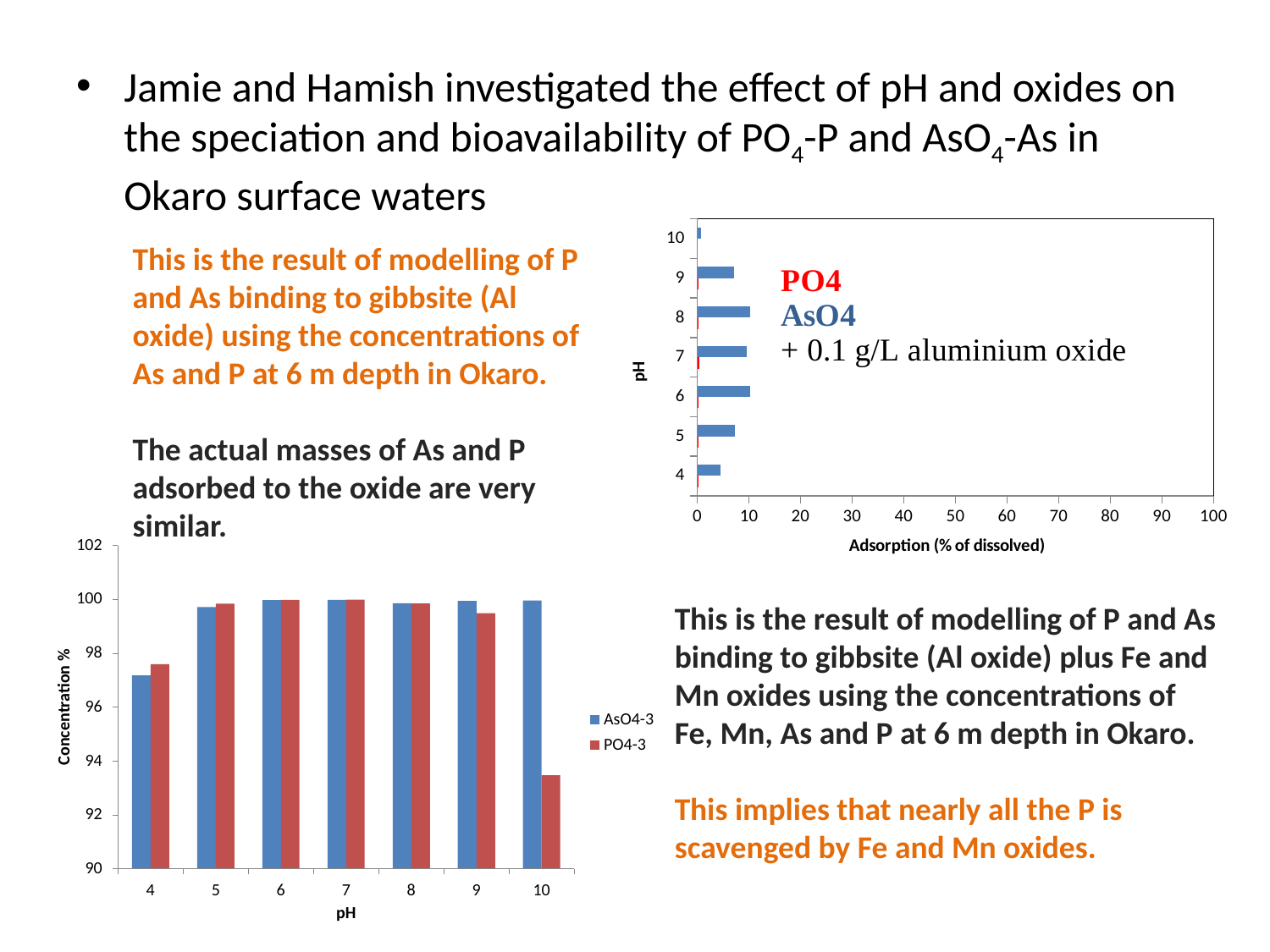
In the bottom-left chart, what are the two series named in the legend? AsO4-3 and PO4-3 In the top-right chart, is the AsO4 adsorption at pH 6 greater or less than 20? less In the bottom-left chart, how many pH categories are shown on the x axis? 7 In the bottom-left chart, is the AsO4-3 value at pH 4 greater or less than 96? greater In the bottom-left chart, is the PO4-3 value at pH 10 greater or less than 96? less In the bottom-left chart, how many series does the legend list? 2 In the bottom-left chart, at pH 10, which series has the larger value, AsO4-3 or PO4-3? AsO4-3 What kind of chart is the chart in the top-right of the slide (Adsorption % of dissolved vs pH)? bar chart In the bottom-left chart, at which pH is the AsO4-3 value lowest? 4 What kind of chart is the chart in the bottom-left of the slide (Concentration % vs pH)? bar chart In the bottom-left chart, at which pH is the PO4-3 value lowest? 10